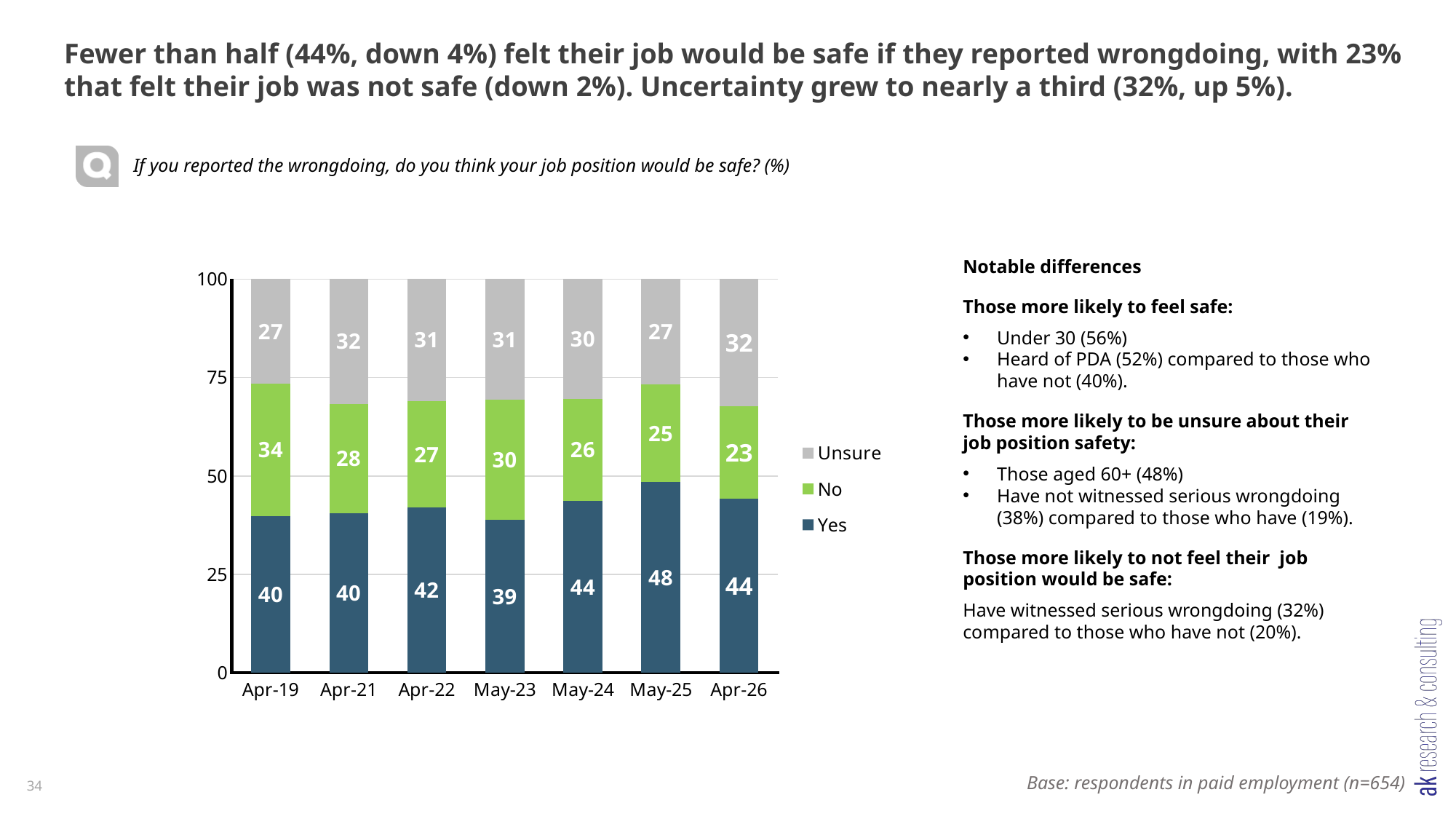
In which period is the Yes value highest? May-25 Which is larger, the No value in Apr-19 or the No value in Apr-26? Apr-19 What is the total of the stacked bar for Apr-22? 100 In which period is the Yes value lowest? May-23 How many series does the legend list? 3 What is the difference between the Yes values for May-25 and Apr-26? 4 How many periods are shown on the x axis? 7 What is the value for No in Apr-19? 34 Which colour represents the Unsure series in the legend? Grey What is the value for Unsure in Apr-26? 32 What is the value for Yes in May-25? 48 What kind of chart is shown? Stacked bar chart